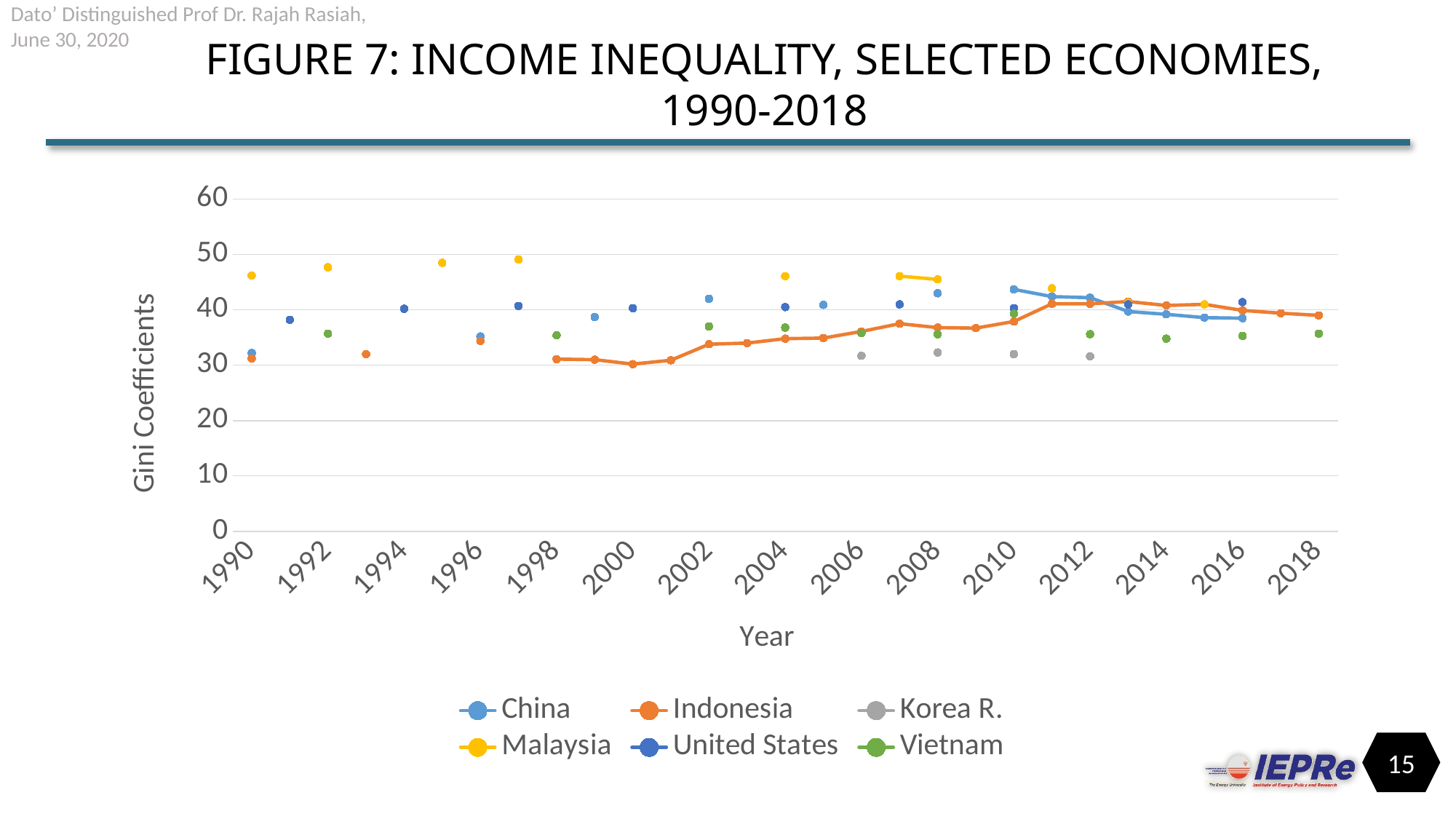
What kind of chart is shown on the slide? Line chart Does the Indonesia line rise or fall between 1998 and 2011? Rise Is the value for Indonesia in 2000 greater or less than 40? less Is the value for Malaysia in 1990 greater or less than 40? greater How many series does the legend list? 6 What is the label on the vertical axis? Gini Coefficients Which series has the highest value in 1990? Malaysia What is the title of the chart? FIGURE 7: INCOME INEQUALITY, SELECTED ECONOMIES, 1990-2018 Is the value for China in 2010 greater or less than 40? greater In 2010, which is larger, the value for China or the value for Vietnam? China Does the China line rise or fall between 2010 and 2016? Fall